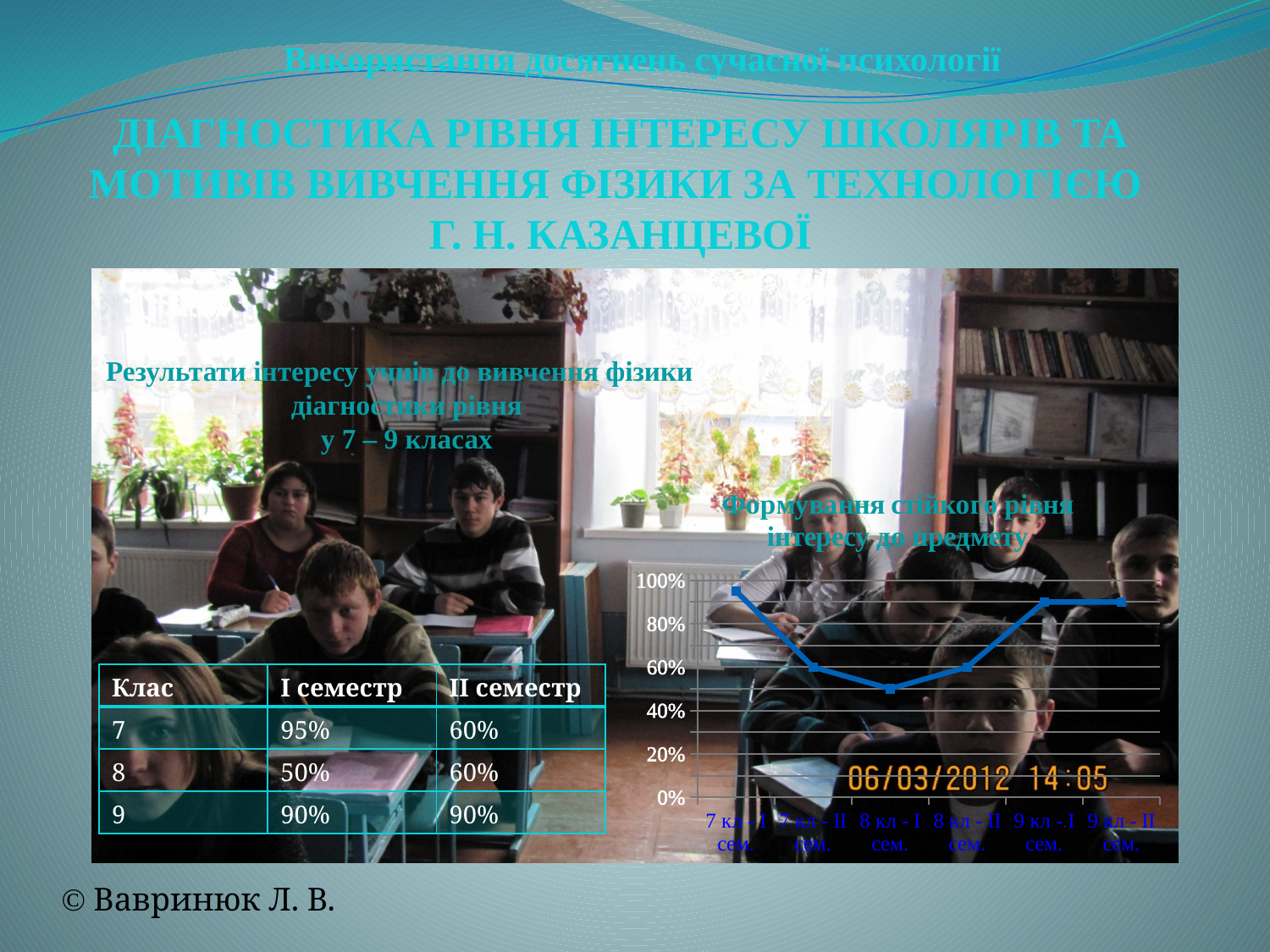
Do the values on the line chart rise or fall from 7 кл - I сем. to 8 кл - I сем.? fall What is the title of the chart on the slide? Формування стійкого рівня інтересу до предмету Is the value for 7 кл - II сем. greater or less than 80%? less What kind of chart is shown on the slide? line chart Which category has the lowest value on the line chart? 8 кл - I сем. Is the value for 9 кл - I сем. greater or less than 80%? greater Is the value for 7 кл - I сем. greater or less than 80%? greater Which is larger on the line chart: the value for 7 кл - I сем. or the value for 8 кл - I сем.? 7 кл - I сем. How many data points are plotted on the line chart? 6